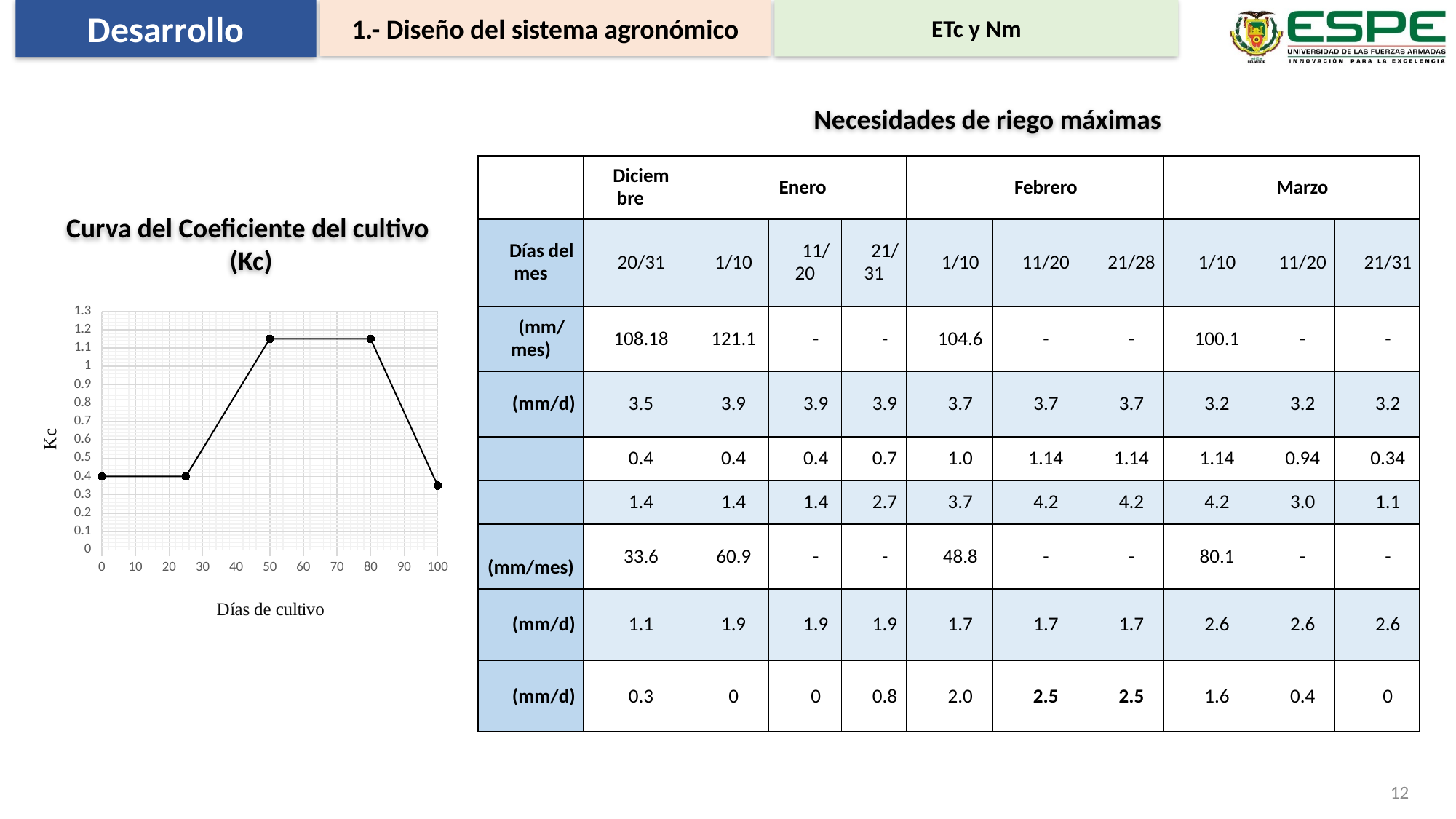
Is the Kc value at day 80 greater or less than 0.9? greater What kind of chart is the 'Curva del Coeficiente del cultivo (Kc)' chart? line chart Is the Kc value at day 50 larger or smaller than the Kc value at day 0? larger Does the Kc curve rise or fall between day 25 and day 50? rise What is the Kc value at day 0 of cultivation? 0.4 Does the Kc curve rise or fall between day 80 and day 100? fall How many data points are plotted on the Kc curve? 5 Is the Kc value at day 50 greater or less than 1? greater What is the label of the y axis of the Kc chart? Kc Is the Kc value at day 100 greater or less than 0.5? less What is the label of the x axis of the Kc chart? Días de cultivo